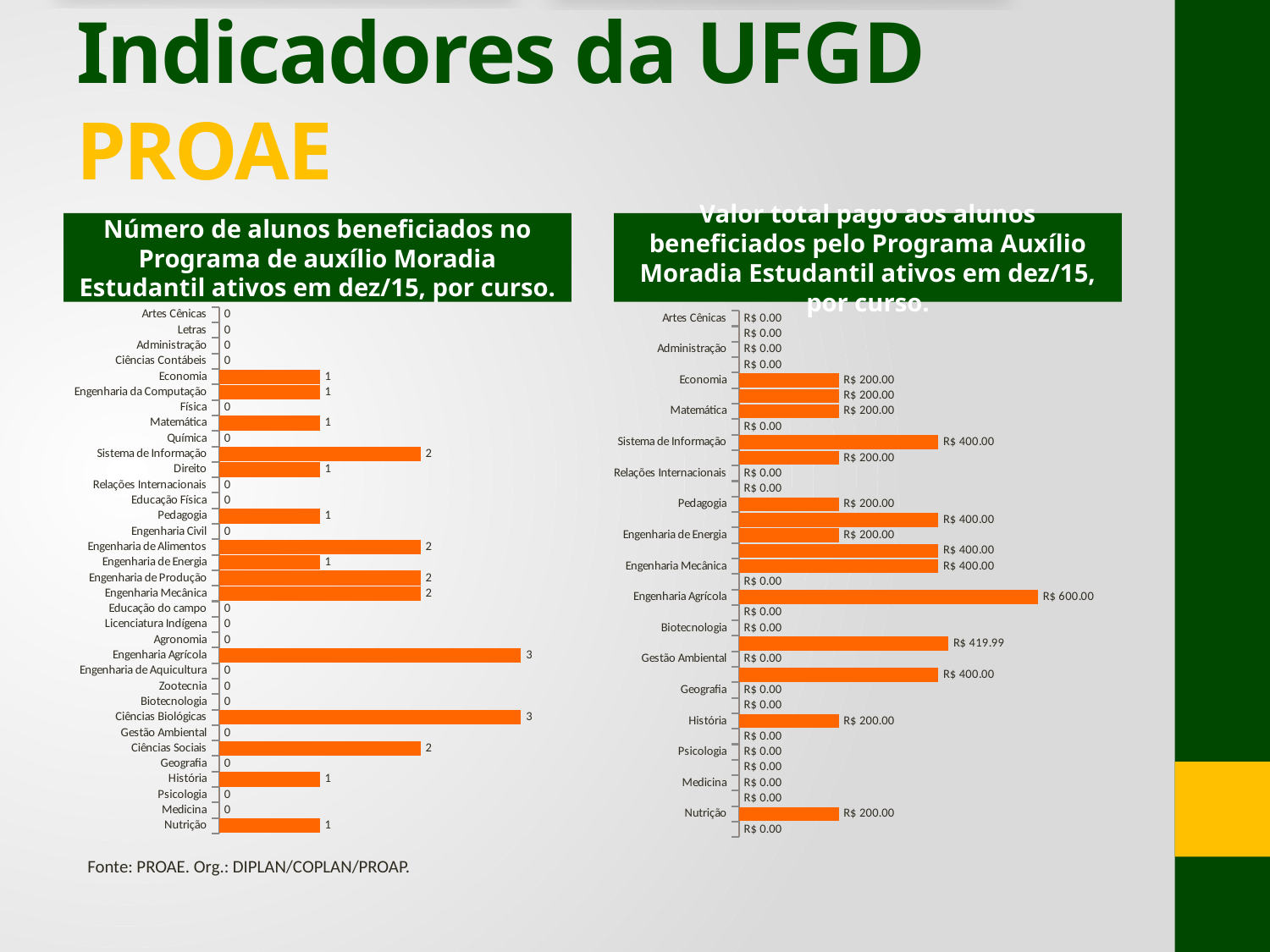
In the left chart (Número de alunos beneficiados), what is the difference between the values for Ciências Biológicas and Ciências Sociais? 1 In the left chart (Número de alunos beneficiados), how many students are shown for Engenharia Agrícola? 3 In the right chart (Valor total pago aos alunos), what is the value for Sistema de Informação? R$ 400.00 In the left chart (Número de alunos beneficiados), which has more students, Engenharia de Alimentos or Engenharia de Energia? Engenharia de Alimentos In the right chart (Valor total pago aos alunos), which labeled course has the highest value? Engenharia Agrícola What type of chart is used on the left side of the slide? Bar chart In the left chart (Número de alunos beneficiados), what is the highest value shown on any bar? 3 In the right chart (Valor total pago aos alunos), what is the difference between the values for Engenharia Mecânica and Engenharia de Energia? R$ 200.00 In the left chart (Número de alunos beneficiados), what is the value for Direito? 1 In the right chart (Valor total pago aos alunos), what is the value for Engenharia Agrícola? R$ 600.00 In the left chart (Número de alunos beneficiados), how many courses are listed on the axis? 34 In the left chart (Número de alunos beneficiados), what is the value for Sistema de Informação? 2